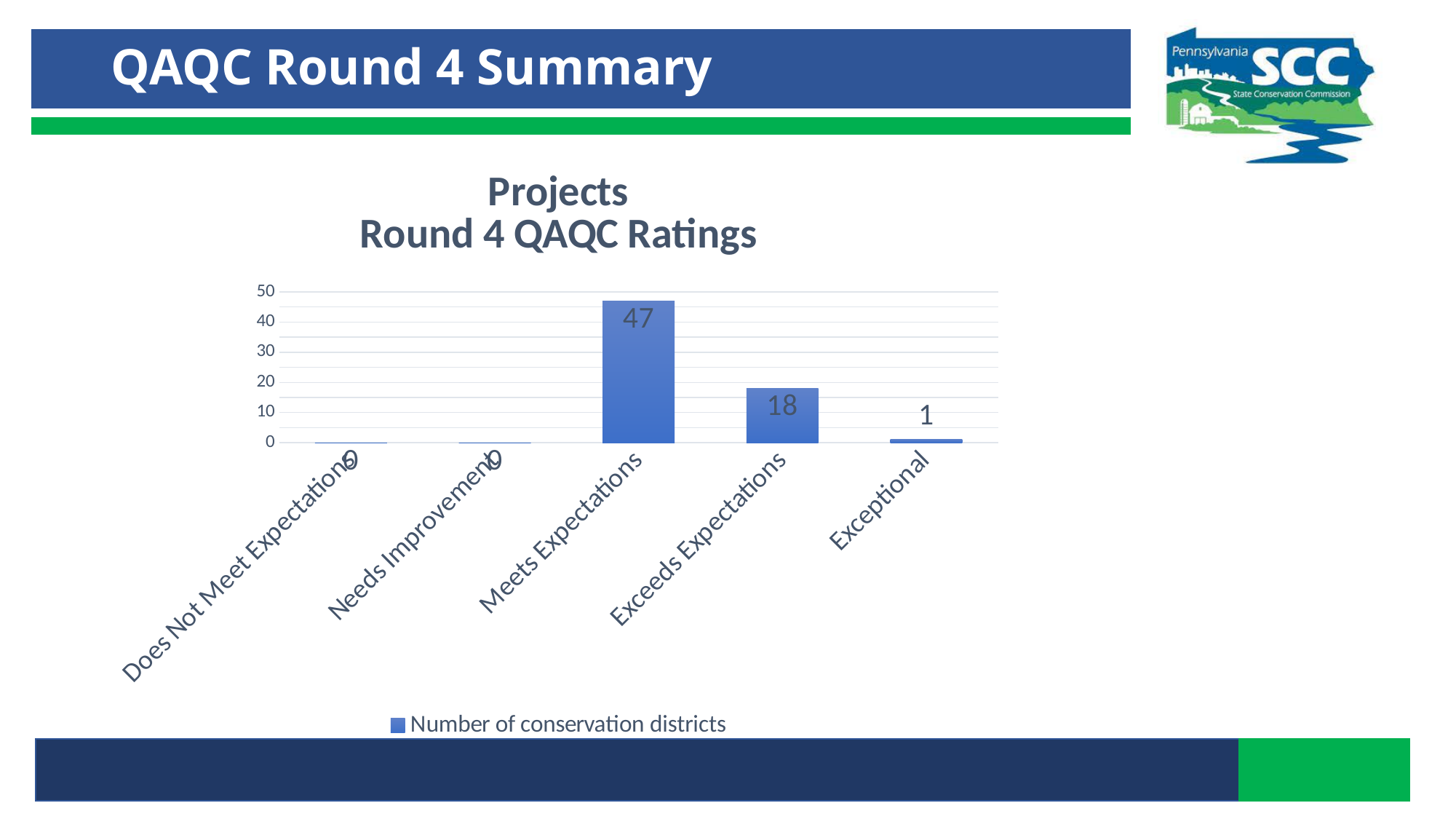
Which has more conservation districts: Exceeds Expectations or Exceptional? Exceeds Expectations What is the number of conservation districts rated Meets Expectations? 47 What is the title of the chart? Projects Round 4 QAQC Ratings Which rating category has the highest number of conservation districts? Meets Expectations What is the number of conservation districts rated Exceeds Expectations? 18 Is the value for Meets Expectations greater or less than 40? greater What is the difference between the number of districts rated Meets Expectations and Exceeds Expectations? 29 What is the number of conservation districts rated Needs Improvement? 0 How many series does the legend list? 1 How many rating categories are shown on the x axis? 5 What kind of chart is shown on the slide? bar chart What is the number of conservation districts rated Exceptional? 1